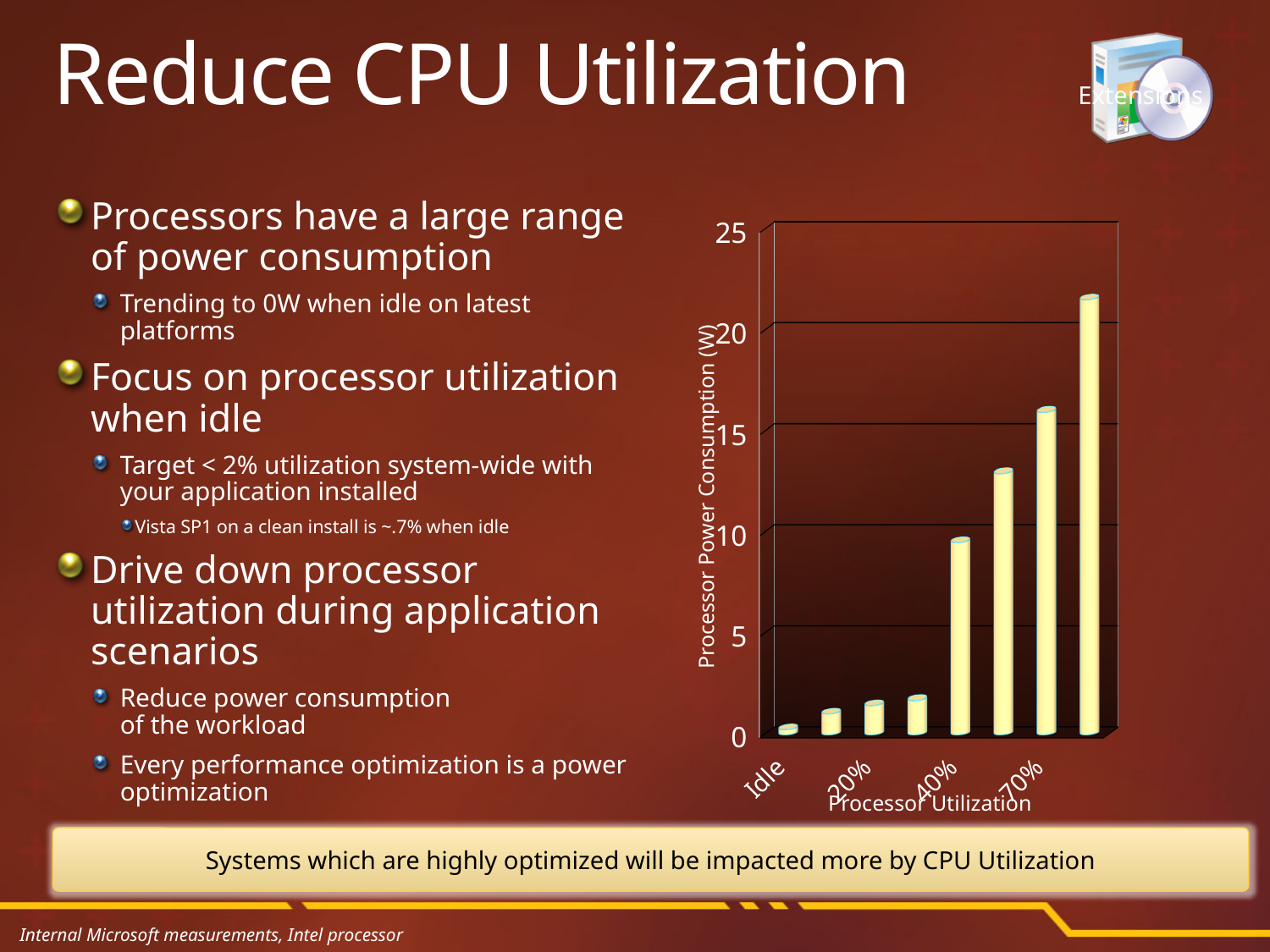
What is the x-axis title of the chart? Processor Utilization What is the y-axis title of the chart? Processor Power Consumption (W) Is the value for 40% greater or less than 5? greater Is the value of the rightmost bar greater or less than 20? greater Is the value for 70% greater or less than 10? greater Do the values rise or fall as processor utilization increases along the x axis? rise Which has the larger value, Idle or 70%? 70% Which labeled category has the lowest value? Idle How many bars are plotted in the chart? 8 What kind of chart is shown on the slide? bar chart